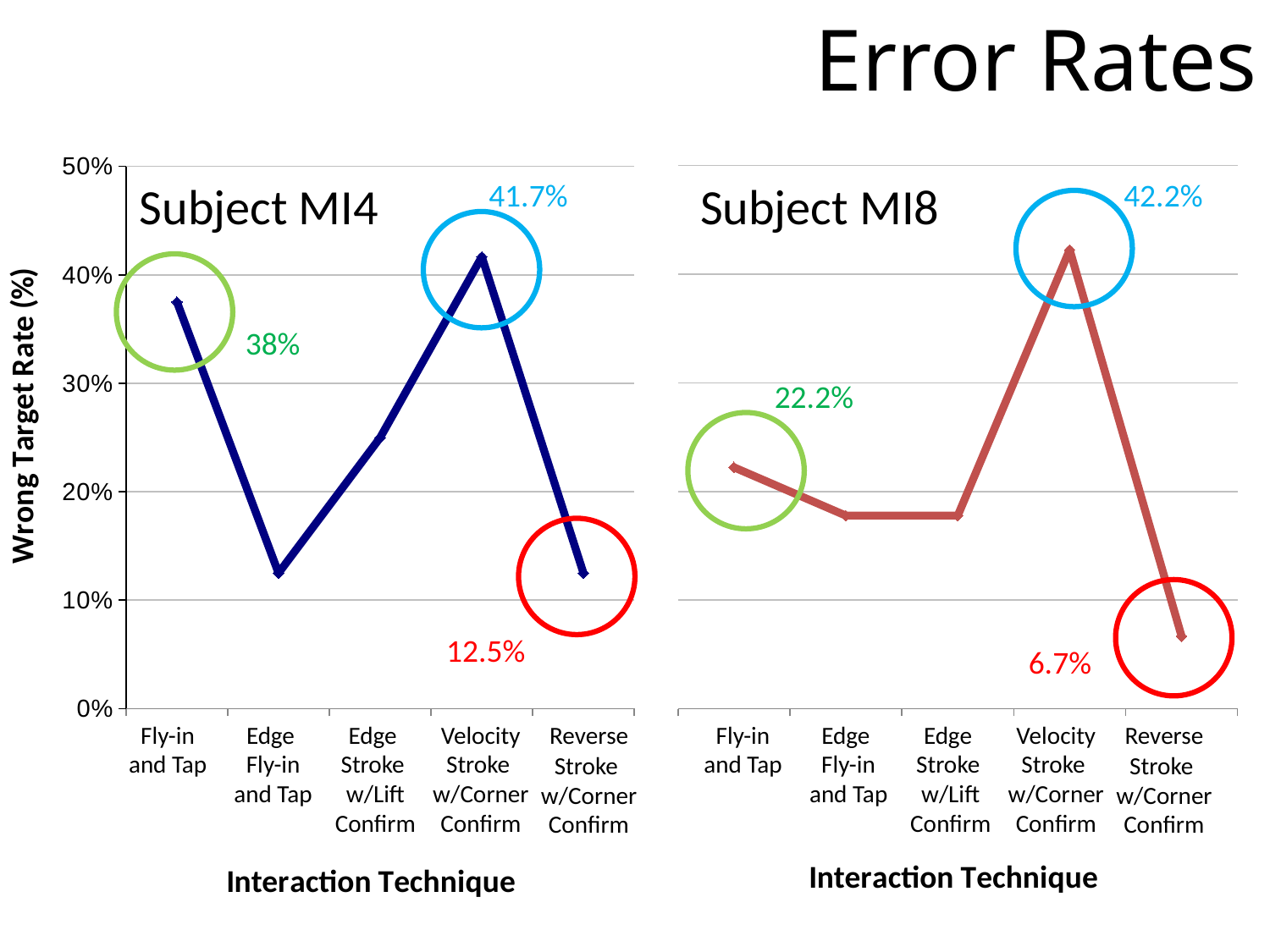
In the Subject MI8 chart, what is the wrong target rate for Reverse Stroke w/Corner Confirm? 6.7% In the Subject MI8 chart, is the value for Edge Fly-in and Tap greater or less than 20%? less In the Subject MI4 chart, what is the wrong target rate for Fly-in and Tap? 38% In the Subject MI4 chart, what is the difference between the wrong target rates for Velocity Stroke w/Corner Confirm and Reverse Stroke w/Corner Confirm? 29.2% In the Subject MI8 chart, which interaction technique has the lowest wrong target rate? Reverse Stroke w/Corner Confirm In the Subject MI8 chart, what is the wrong target rate for Fly-in and Tap? 22.2% In the Subject MI8 chart, which interaction technique has the highest wrong target rate? Velocity Stroke w/Corner Confirm In the Subject MI4 chart, which interaction technique has the highest wrong target rate? Velocity Stroke w/Corner Confirm In the Subject MI4 chart, what is the wrong target rate for Velocity Stroke w/Corner Confirm? 41.7% In the Subject MI4 chart, is the value for Edge Stroke w/Lift Confirm greater or less than 20%? greater How many interaction techniques are plotted on the x axis of the Subject MI8 chart? 5 Which subject has the higher wrong target rate for Fly-in and Tap, MI4 or MI8? MI4